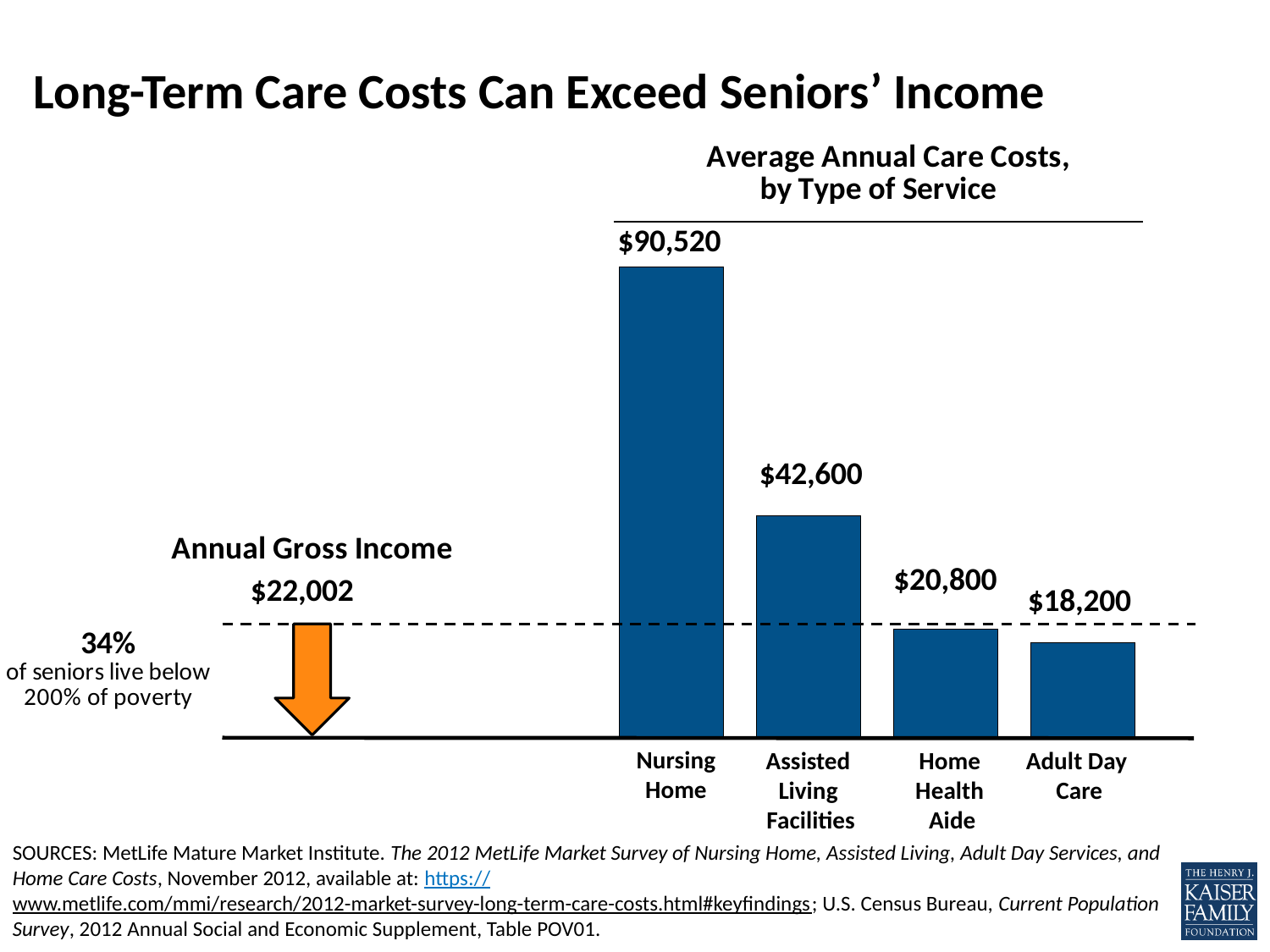
Which type of service has the highest average annual care cost? Nursing Home What is the difference between the average annual cost of a Home Health Aide and Adult Day Care? $2,600 Which costs more per year, Assisted Living Facilities or a Home Health Aide? Assisted Living Facilities Which type of service has the lowest average annual care cost? Adult Day Care How many types of service are shown as bars in the chart? 4 What is the average annual care cost for Adult Day Care? $18,200 What is the average annual care cost for Assisted Living Facilities? $42,600 What kind of chart is used to show the average annual care costs? Bar chart What is the difference between the average annual cost of a Nursing Home and Assisted Living Facilities? $47,920 What is the average annual care cost for a Home Health Aide? $20,800 What is the average annual care cost for a Nursing Home? $90,520 What annual gross income value is marked by the dashed line on the chart? $22,002